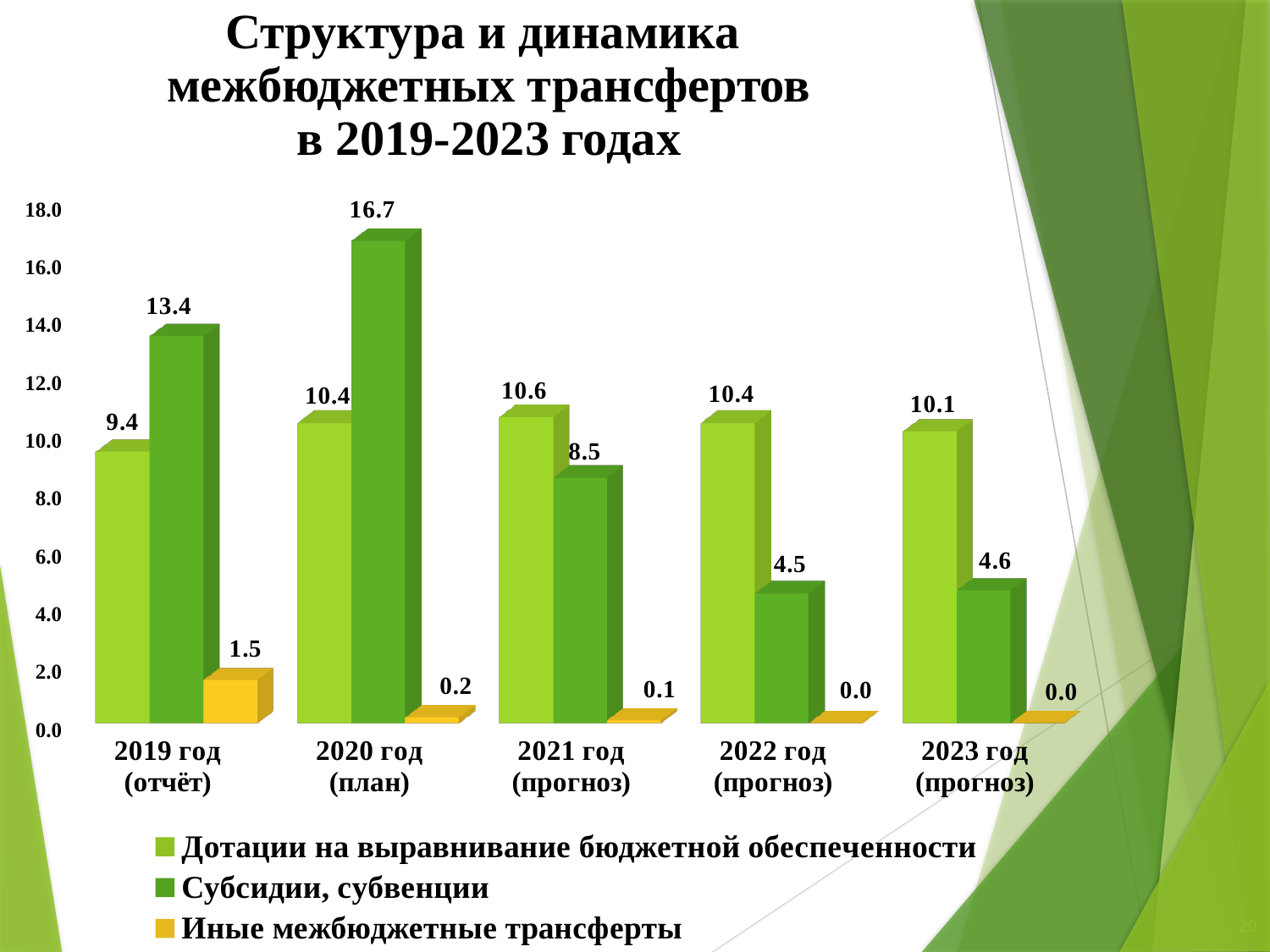
Which is larger in 2021 год (прогноз): Дотации на выравнивание бюджетной обеспеченности or Субсидии, субвенции? Дотации на выравнивание бюджетной обеспеченности What is the value of Субсидии, субвенции for 2023 год (прогноз)? 4.6 In which year is the value of Субсидии, субвенции highest? 2020 год (план) Does the value of Субсидии, субвенции rise or fall from 2020 год (план) to 2022 год (прогноз)? Fall What is the value of Иные межбюджетные трансферты for 2019 год (отчёт)? 1.5 What kind of chart is shown on the slide? Bar chart How many year categories are shown on the x axis? 5 What is the value of Дотации на выравнивание бюджетной обеспеченности for 2019 год (отчёт)? 9.4 How many series does the legend list? 3 In which year is the value of Субсидии, субвенции lowest? 2022 год (прогноз) What is the difference between Субсидии, субвенции and Дотации на выравнивание бюджетной обеспеченности in 2020 год (план)? 6.3 What is the value of Субсидии, субвенции for 2020 год (план)? 16.7